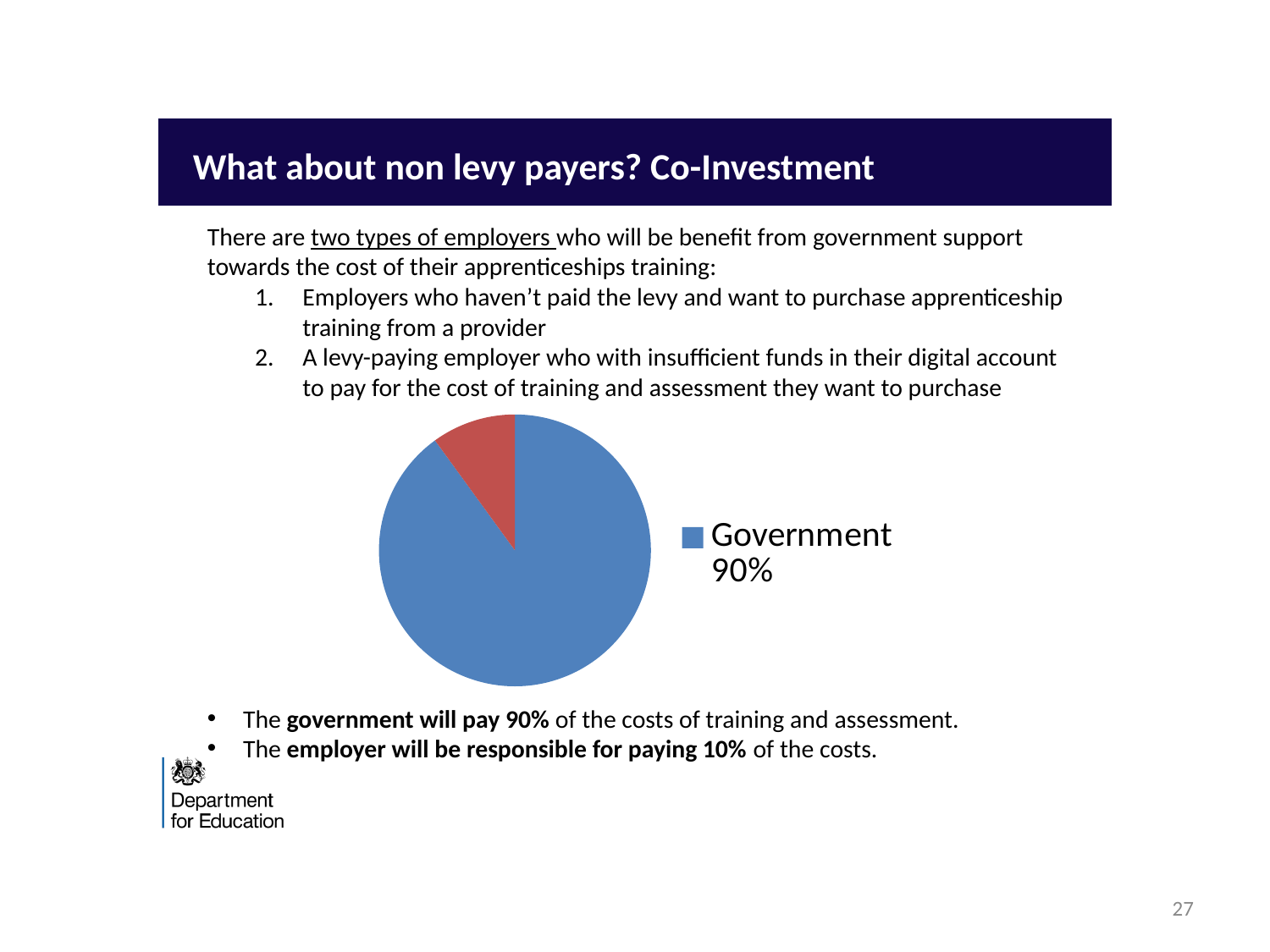
What share of the pie does the Government slice represent? 90% What colour is the Government slice in the pie chart? blue According to the slide, what share of the costs does the smaller (red) slice, the employer, represent? 10% Is the Government slice larger or smaller than the red slice? larger What is the only entry shown in the pie chart's legend? Government 90% How many slices does the pie chart have? 2 How many entries does the chart's legend list? 1 Which slice of the pie chart is the largest? Government What kind of chart is shown on the slide? pie chart